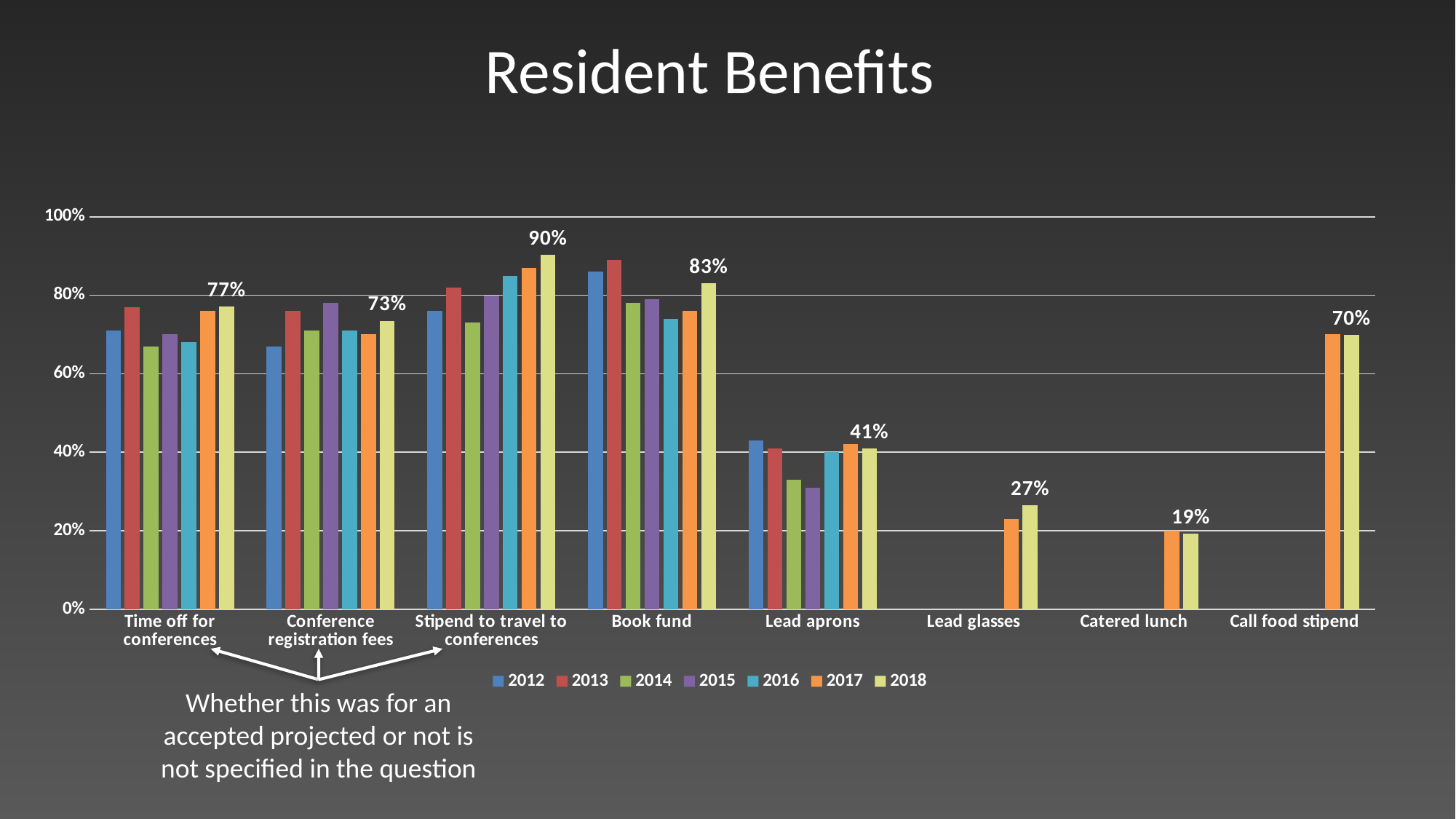
How many benefit categories are shown on the x axis? 8 What is the difference between the 2018 values for Stipend to travel to conferences and Book fund? 7 percentage points What type of chart is shown on the slide? Bar chart What is the 2018 value for Call food stipend? 70% Is the 2012 value for Book fund greater or less than 80%? greater What is the 2018 value for Stipend to travel to conferences? 90% Which is larger in 2018: Lead aprons or Lead glasses? Lead aprons What is the 2018 value for Lead glasses? 27% Among the 2018 values labelled on the chart, which category is lowest? Catered lunch How many years does the legend list? 7 Among the 2018 values labelled on the chart, which category is highest? Stipend to travel to conferences Is the 2014 value for Lead aprons greater or less than 40%? less